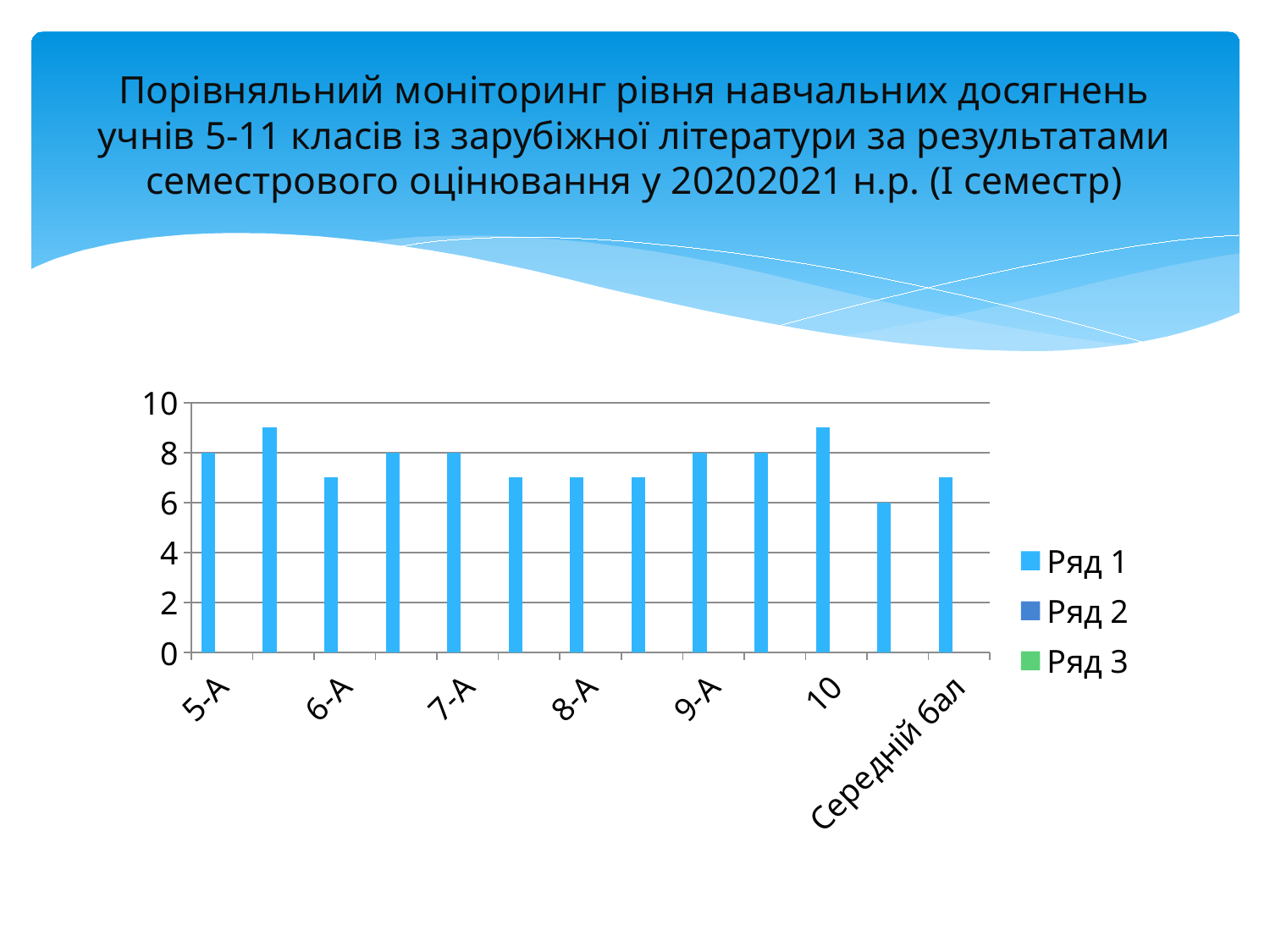
What is the value for 9-А? 8 How many series does the legend list? 3 What is the value for 5-А? 8 What kind of chart is shown on the slide? bar chart Is the value for 8-А greater or less than 8? less Is the value for Середній бал greater or less than 6? greater Is the value for 10 greater or less than 8? greater Which is larger, the value for 5-А or the value for 6-А? 5-А What is the value for 7-А? 8 Which is larger, the value for 10 or the value for Середній бал? 10 How many bars are plotted in the chart? 13